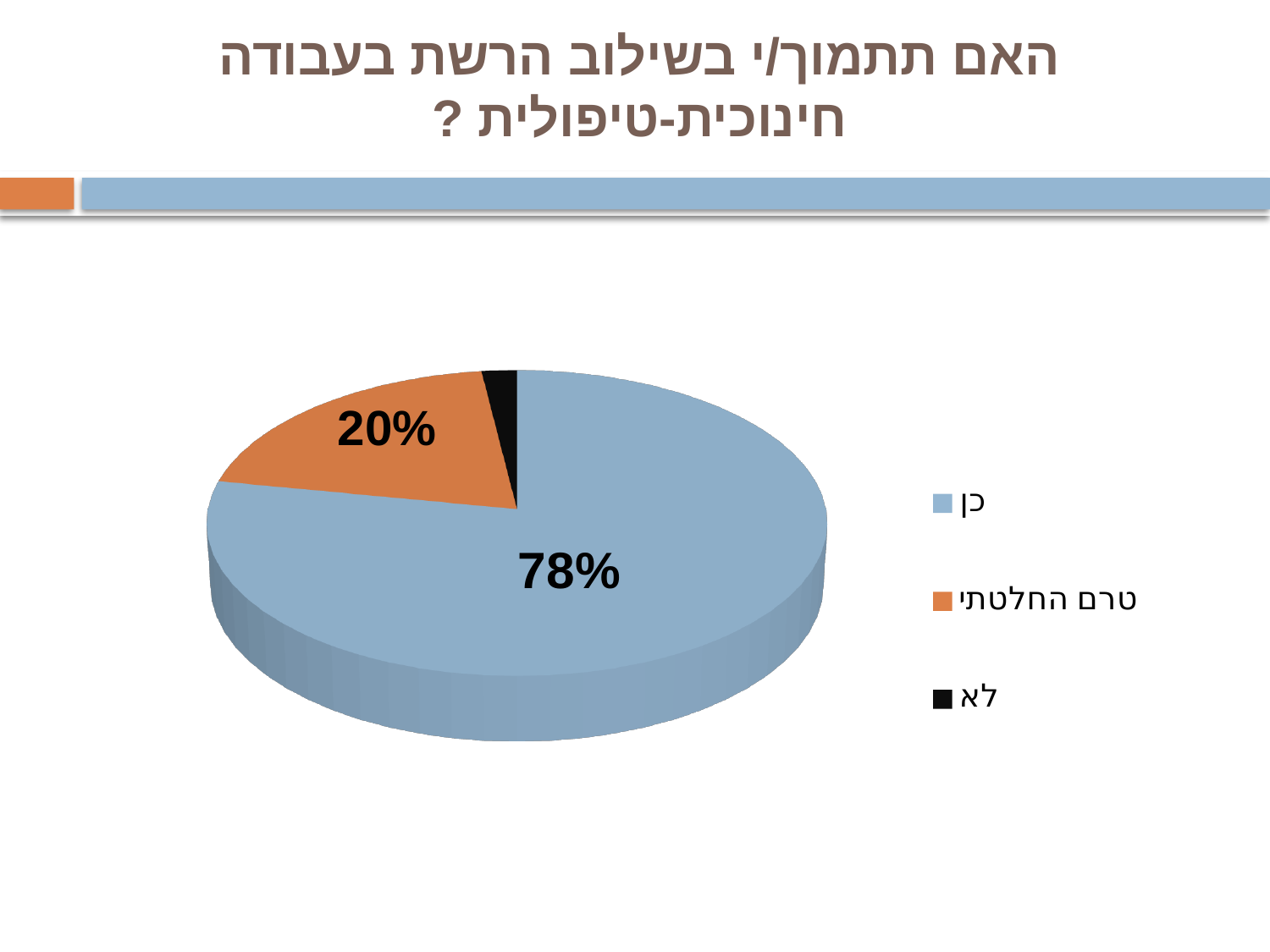
What kind of chart is shown on the slide? pie chart Which category has the smallest slice of the pie chart? לא What colour is the "טרם החלטתי" slice in the pie chart? orange Which slice is larger, "טרם החלטתי" or "לא"? טרם החלטתי What percentage of the pie chart is labelled for the category "טרם החלטתי"? 20% What colour is the "לא" slice in the pie chart? black Which slice is larger, "כן" or "טרם החלטתי"? כן What percentage of the pie chart is labelled for the category "כן"? 78% How many categories does the pie chart show? 3 Which category has the largest slice of the pie chart? כן What share of the pie does the "כן" slice represent? 78% What is the difference in percentage points between the "כן" slice and the "טרם החלטתי" slice? 58